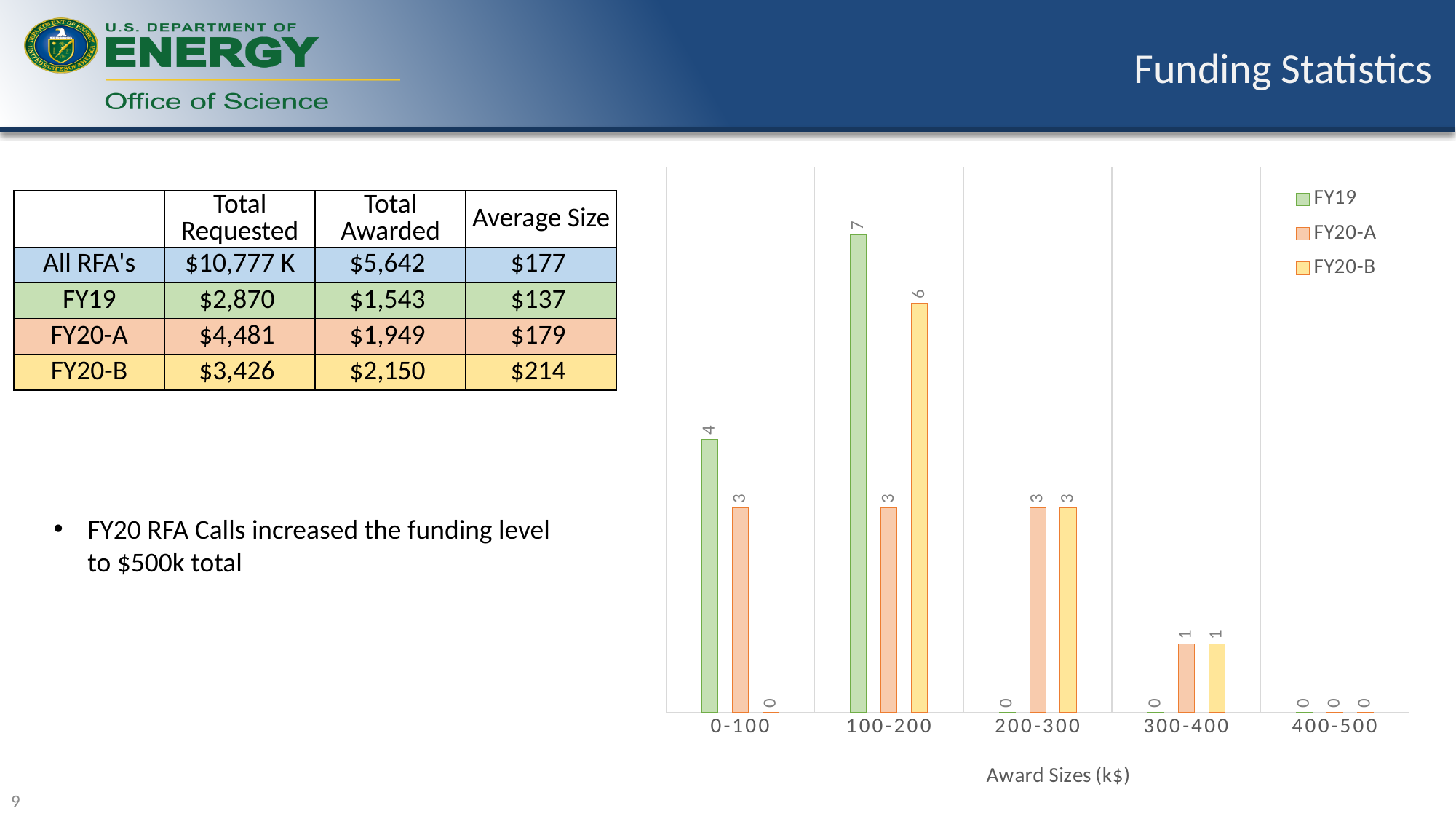
Which is larger in the 0-100 category, the FY19 value or the FY20-A value? FY19 What is the FY20-A value for the 0-100 award size category? 3 What is the FY19 value for the 100-200 award size category? 7 What is the FY20-B value for the 100-200 award size category? 6 What is the difference between the FY19 and FY20-A values in the 100-200 category? 4 What is the x axis title of the chart? Award Sizes (k$) Which award size category has the highest FY19 value? 100-200 How many award size categories are shown on the x axis of the chart? 5 What type of chart is shown on the slide? bar chart What is the FY20-B value for the 300-400 award size category? 1 What is the FY19 value for the 200-300 award size category? 0 How many series does the chart legend list? 3